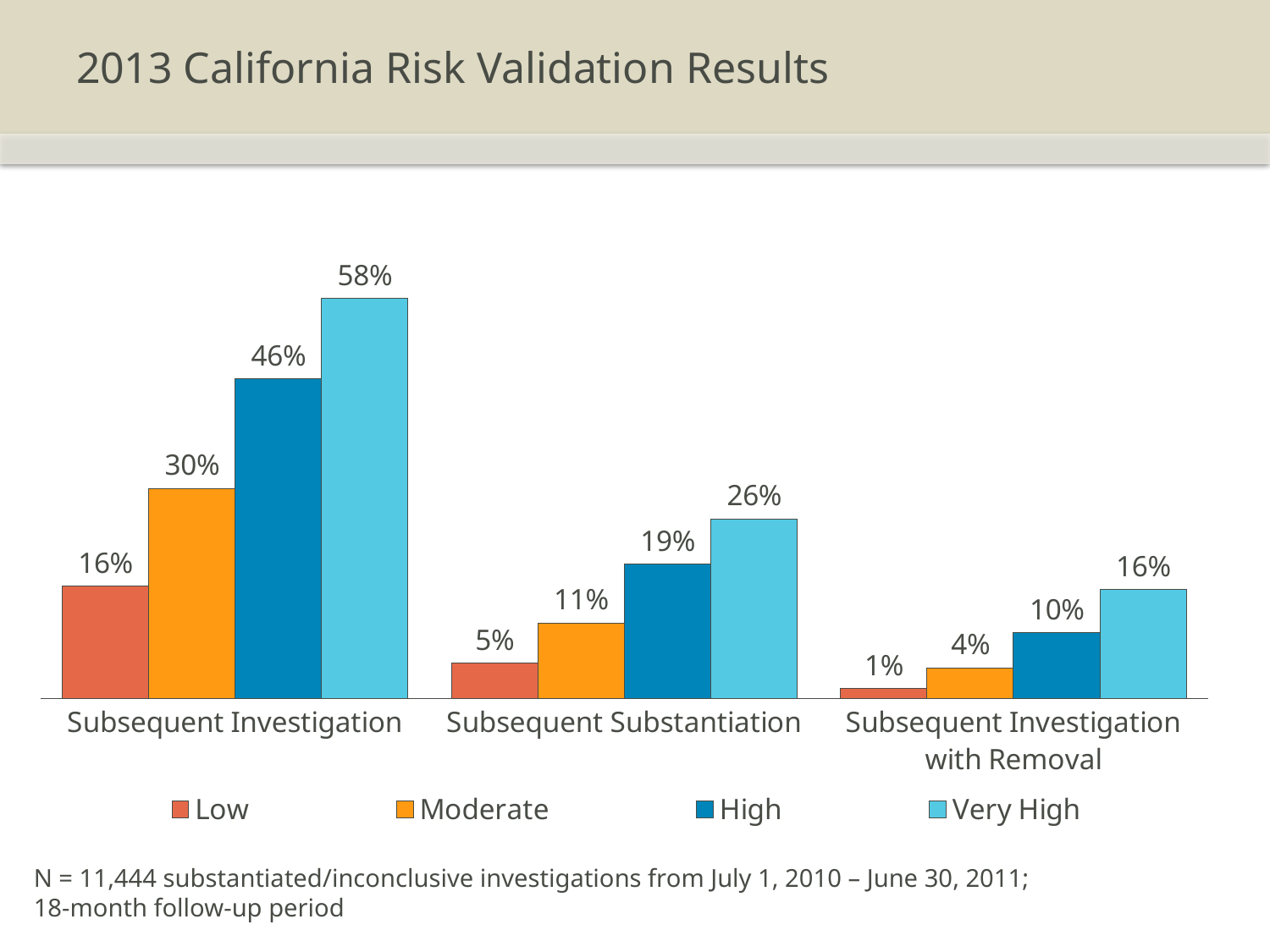
What is the difference between the Very High and Low values in the Subsequent Investigation category? 42% Which is larger: the High value for Subsequent Investigation or the Very High value for Subsequent Substantiation? High value for Subsequent Investigation What is the value for Low in the Subsequent Substantiation category? 5% What is the value for Very High in the Subsequent Investigation category? 58% What is the difference between the High and Moderate values in the Subsequent Substantiation category? 8% Which risk level has the lowest value in the Subsequent Investigation with Removal category? Low How many categories are shown on the x axis? 3 What is the value for Moderate in the Subsequent Investigation with Removal category? 4% What kind of chart is shown on the slide? Bar chart Which risk level has the highest value in the Subsequent Substantiation category? Very High What is the title of the slide? 2013 California Risk Validation Results How many series does the legend list? 4